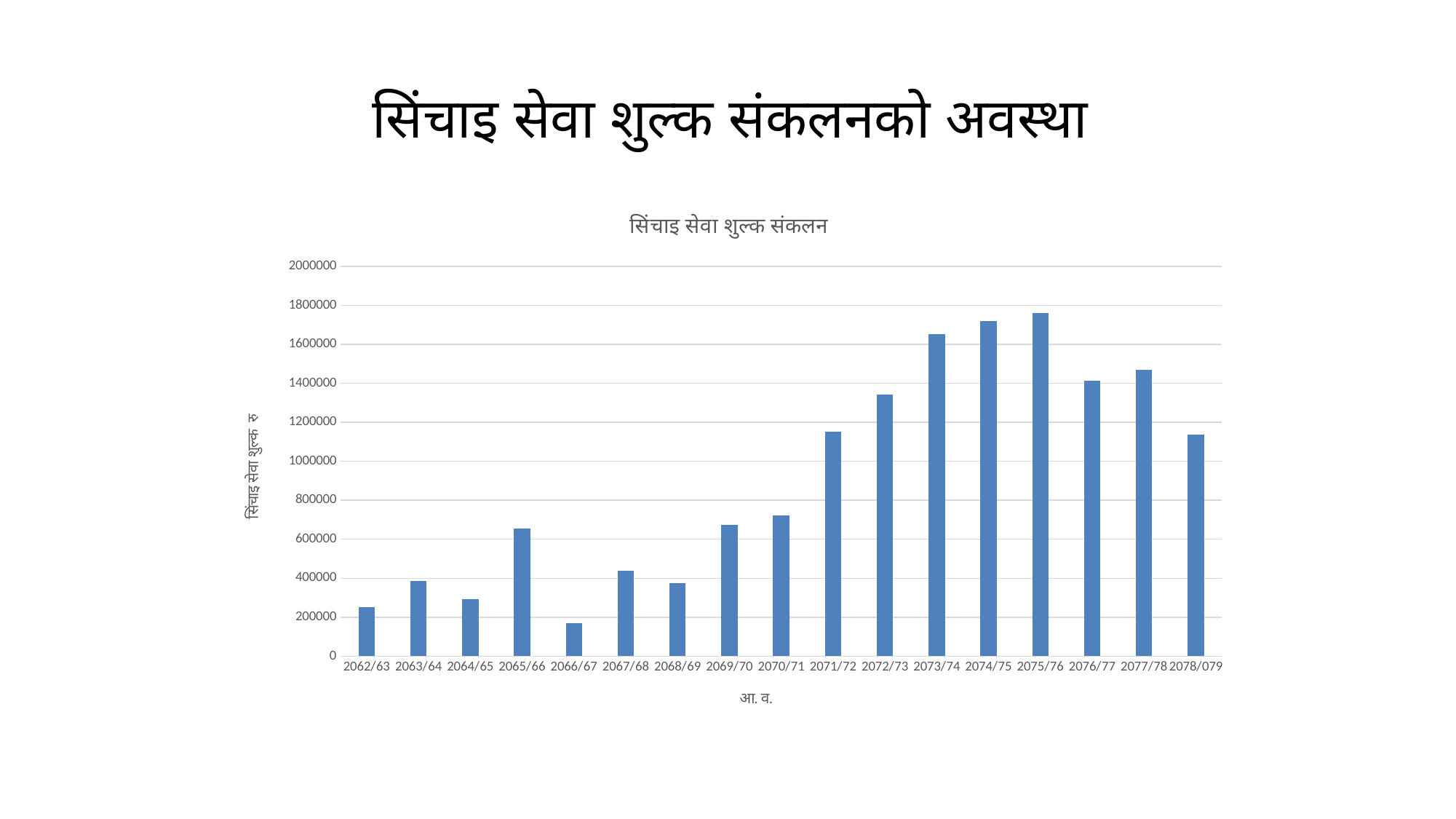
Is the value for 2062/63 greater or less than 200000? greater Do the values rise or fall from 2071/72 to 2075/76? rise Is the value for 2071/72 greater or less than 1000000? greater What is the title of the chart? सिंचाइ सेवा शुल्क संकलन Is the value for 2077/78 greater or less than 1400000? greater Which fiscal year has the highest value? 2075/76 Which is larger, the value for 2073/74 or the value for 2076/77? 2073/74 Which fiscal year has the lowest value? 2066/67 How many fiscal years (categories) are plotted on the x axis? 17 What kind of chart is shown on the slide? bar chart